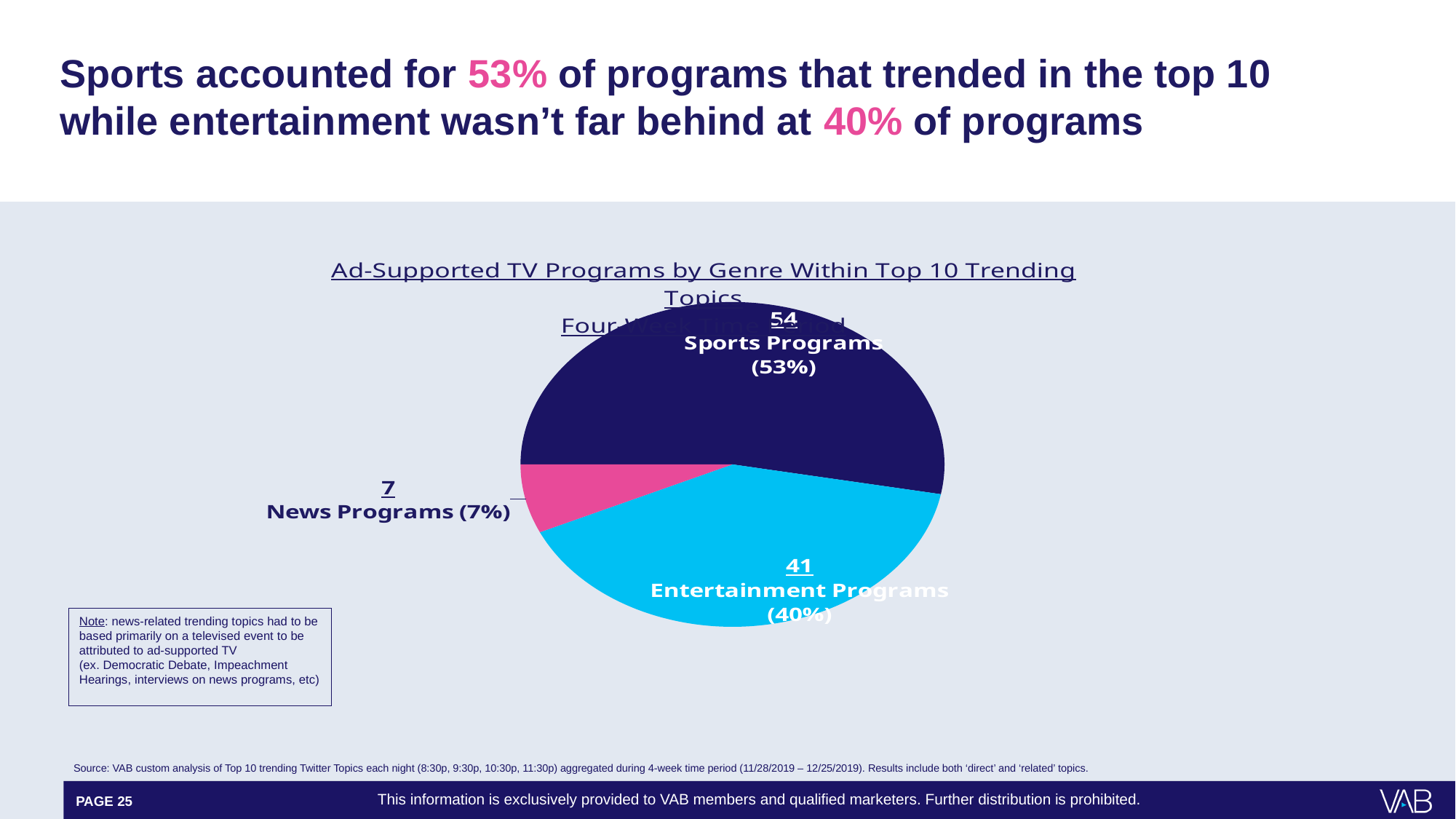
What share of the pie do Entertainment Programs account for? 40% How many programs are in the Sports Programs slice? 54 How many genre categories does the pie chart show? 3 Which genre has the smallest slice of the pie? News Programs How many more programs are in the Sports Programs slice than in the Entertainment Programs slice? 13 What kind of chart is shown on the slide? Pie chart How many programs are in the Entertainment Programs slice? 41 What share of the pie do Sports Programs account for? 53% Which genre has the largest slice of the pie? Sports Programs Which slice is larger, Entertainment Programs or News Programs? Entertainment Programs What share of the pie do News Programs account for? 7% How many programs are in the News Programs slice? 7